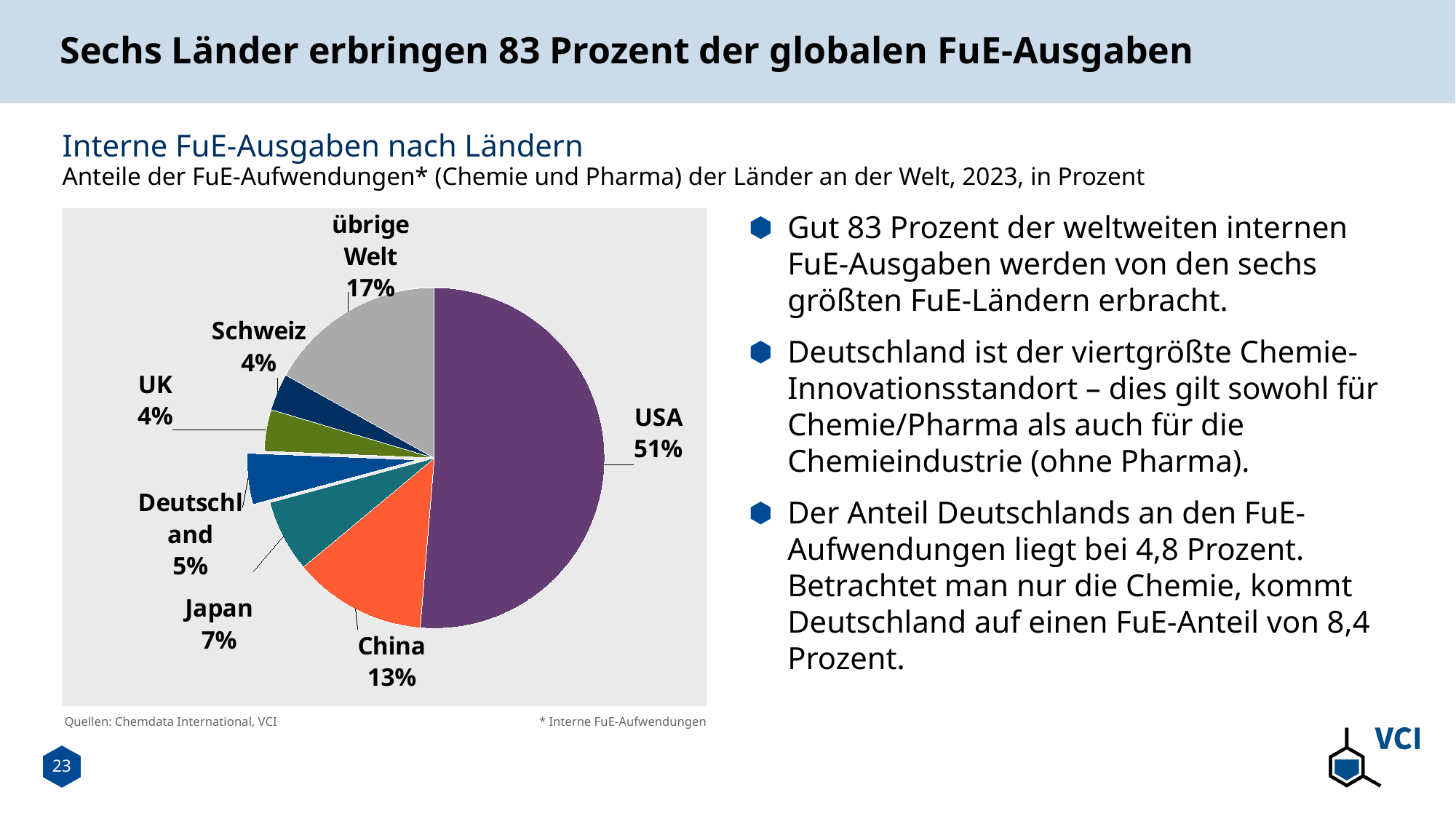
What is the difference in percentage points between the USA slice and the China slice? 38 What is the value shown for Deutschland in the pie chart? 5% What is the value shown for China in the pie chart? 13% What is the difference in percentage points between the übrige Welt slice and the Deutschland slice? 12 What share of global R&D spending does the USA account for in the pie chart? 51% Which country has the largest slice in the pie chart? USA What is the value shown for Japan in the pie chart? 7% Which slice is larger, China or Japan? China What is the title of the chart on the slide? Interne FuE-Ausgaben nach Ländern What is the value shown for übrige Welt in the pie chart? 17% How many slices does the pie chart have? 7 What kind of chart is shown on the slide? Pie chart